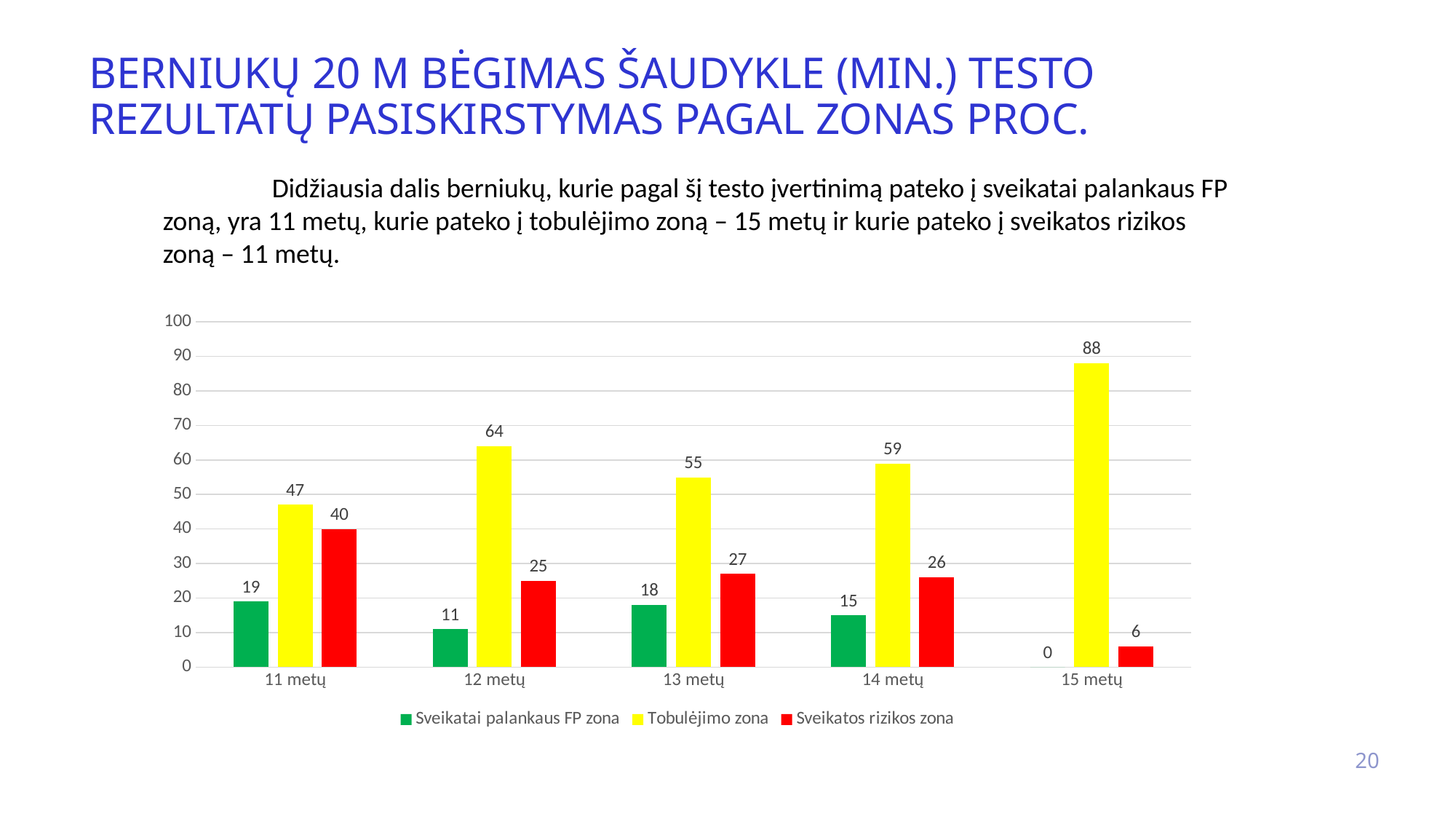
What is the difference between the Tobulėjimo zona value and the Sveikatos rizikos zona value at 12 metų? 39 Which colour represents Sveikatos rizikos zona in the legend? Red Which is larger at 11 metų: Tobulėjimo zona or Sveikatos rizikos zona? Tobulėjimo zona What kind of chart is shown on the slide? Bar chart How many series does the legend list? 3 What is the value for Sveikatai palankaus FP zona at 11 metų? 19 What is the value for Tobulėjimo zona at 15 metų? 88 What is the value for Sveikatos rizikos zona at 13 metų? 27 Which age group has the lowest value for Sveikatai palankaus FP zona? 15 metų Which age group has the highest value for Tobulėjimo zona? 15 metų Does the Sveikatai palankaus FP zona value rise or fall from 13 metų to 15 metų? Fall How many age groups are shown on the x axis? 5